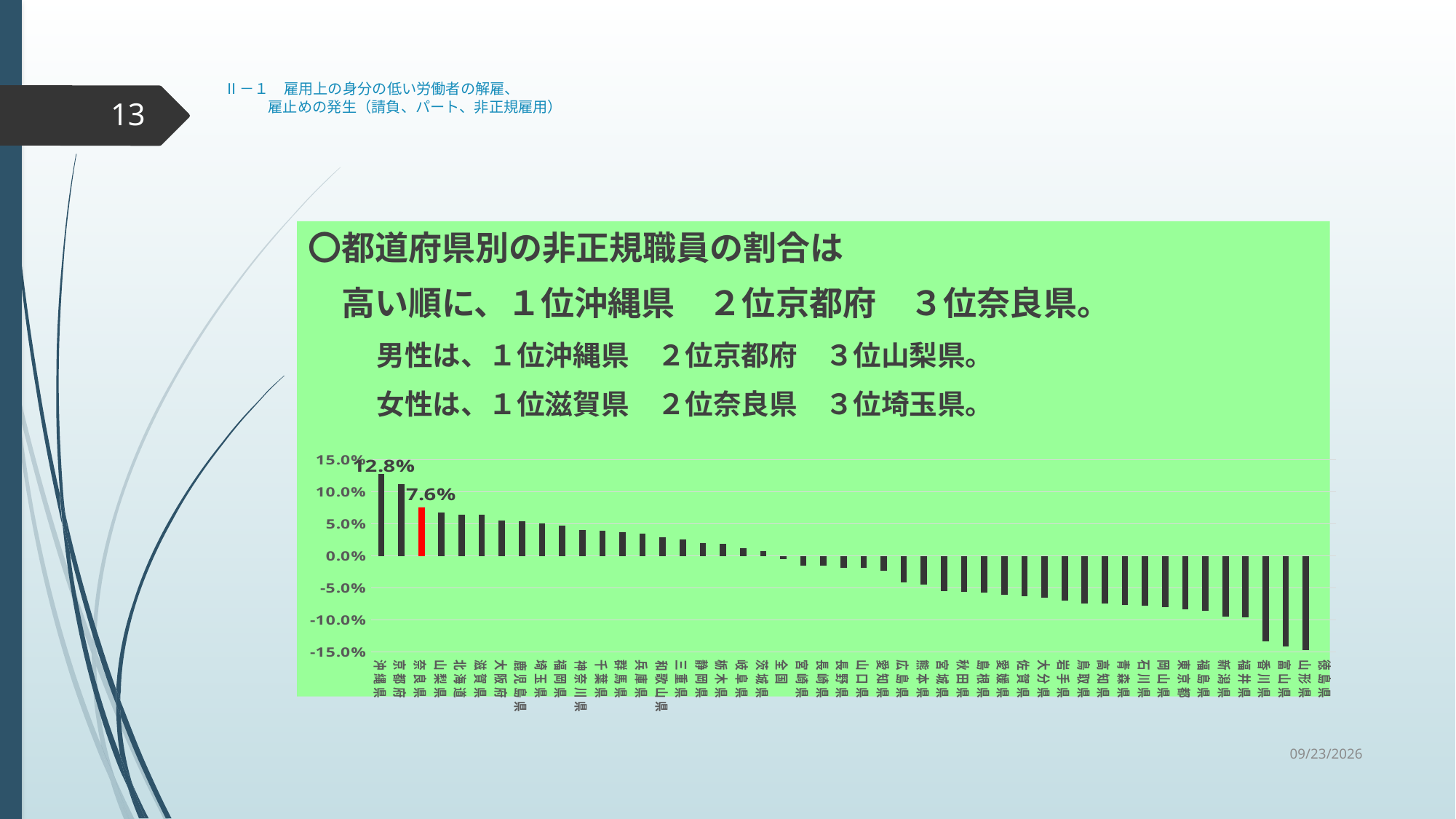
Which category has the lowest value in the bar chart? 山形県 What kind of chart is shown on the slide? bar chart Is the value for 山梨県 greater or less than 5.0%? greater Is the value for 奈良県 greater or less than 10.0%? less What is the value for 沖縄県 in the bar chart? 12.8% Which is larger, the value for 沖縄県 or the value for 京都府? 沖縄県 Which category has the highest value in the bar chart? 沖縄県 Which category's bar is coloured red in the chart? 奈良県 Do the values rise or fall from left to right along the x axis? fall